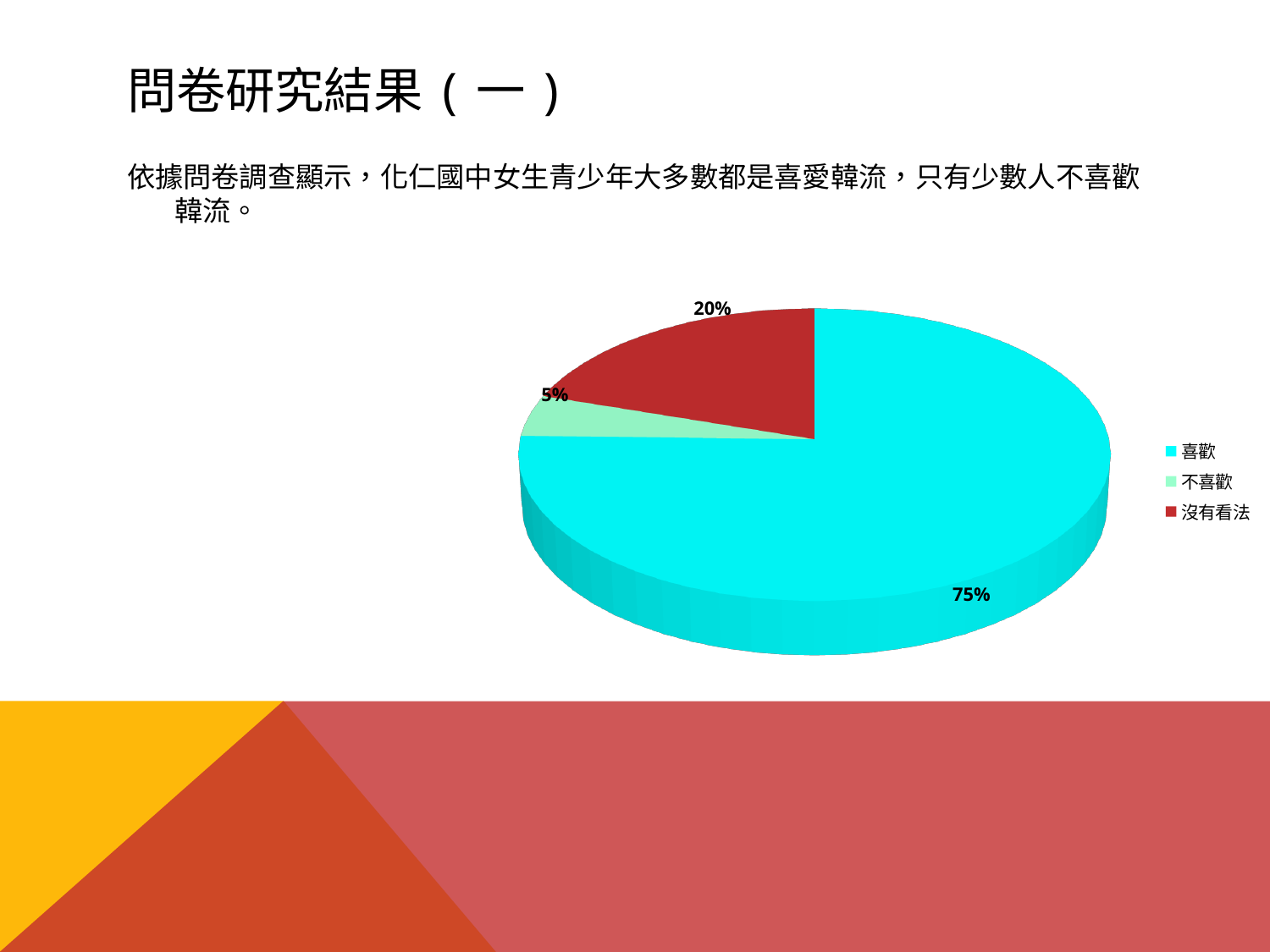
Which category has the largest slice of the pie? 喜歡 How many entries does the legend list? 3 How many slices does the pie chart have? 3 What share of the pie does 沒有看法 take? 20% What kind of chart is shown on the slide? pie chart What is the difference in percentage points between 沒有看法 and 不喜歡? 15% What is the difference in percentage points between 喜歡 and 沒有看法? 55% What colour is the slice for 喜歡? cyan What share of the pie does 喜歡 take? 75% What share of the pie does 不喜歡 take? 5% Which is larger, the slice for 沒有看法 or the slice for 不喜歡? 沒有看法 Which category has the smallest slice of the pie? 不喜歡